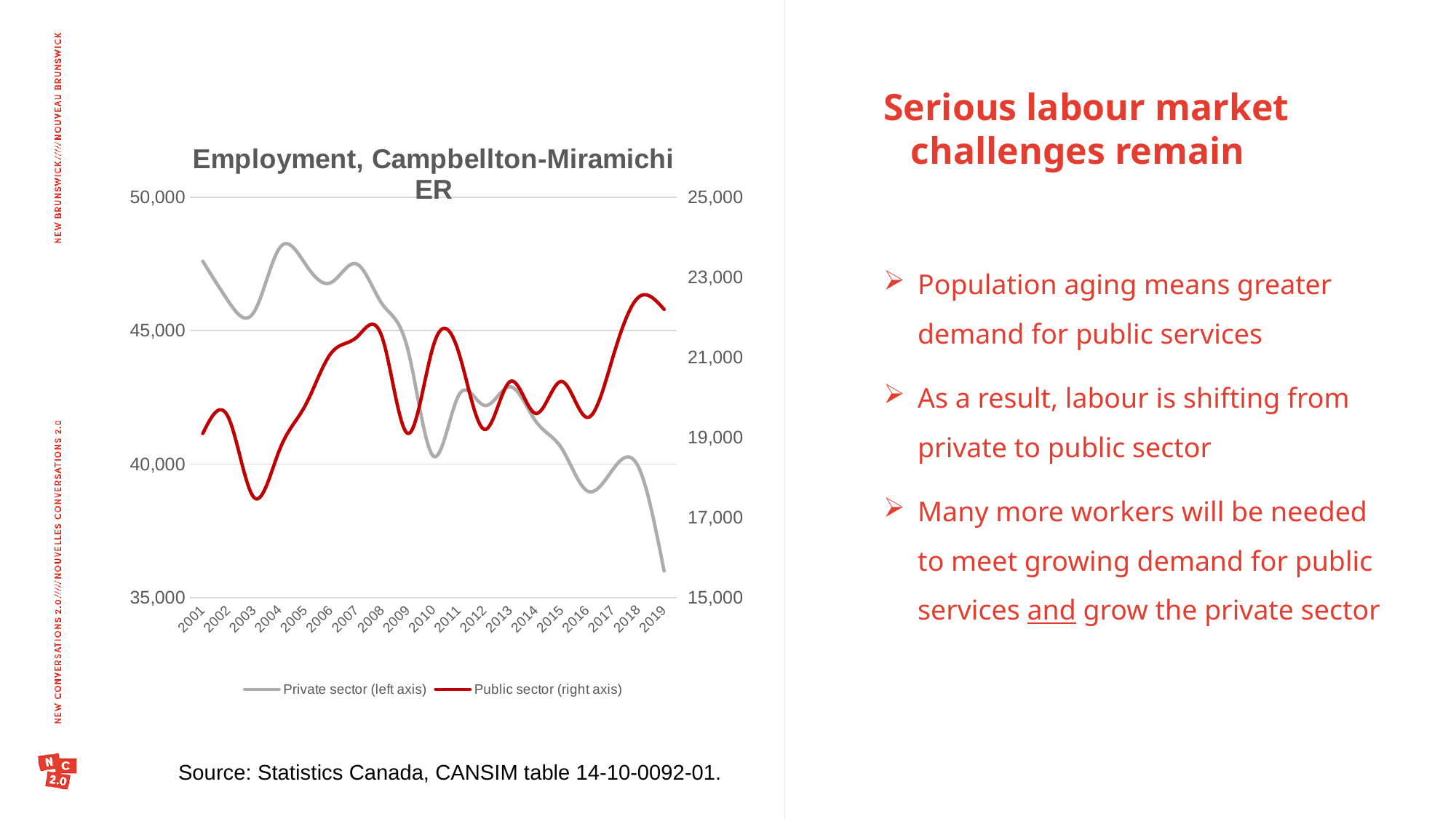
How many years are plotted along the x axis? 19 In which year is the Private sector line at its lowest? 2019 Is the Public sector value for 2003 greater or less than 19,000? less What kind of chart is shown on the slide? Line chart Which series is plotted against the right axis? Public sector Overall, does the Private sector line rise or fall from 2001 to 2019? Fall In which year is the Public sector line at its highest? 2018 Is the Public sector value for 2018 greater or less than 21,000? greater What is the title of the chart? Employment, Campbellton-Miramichi ER In which year is the Public sector line at its lowest? 2003 Is the Private sector value for 2019 greater or less than 40,000? less How many series does the legend list? 2